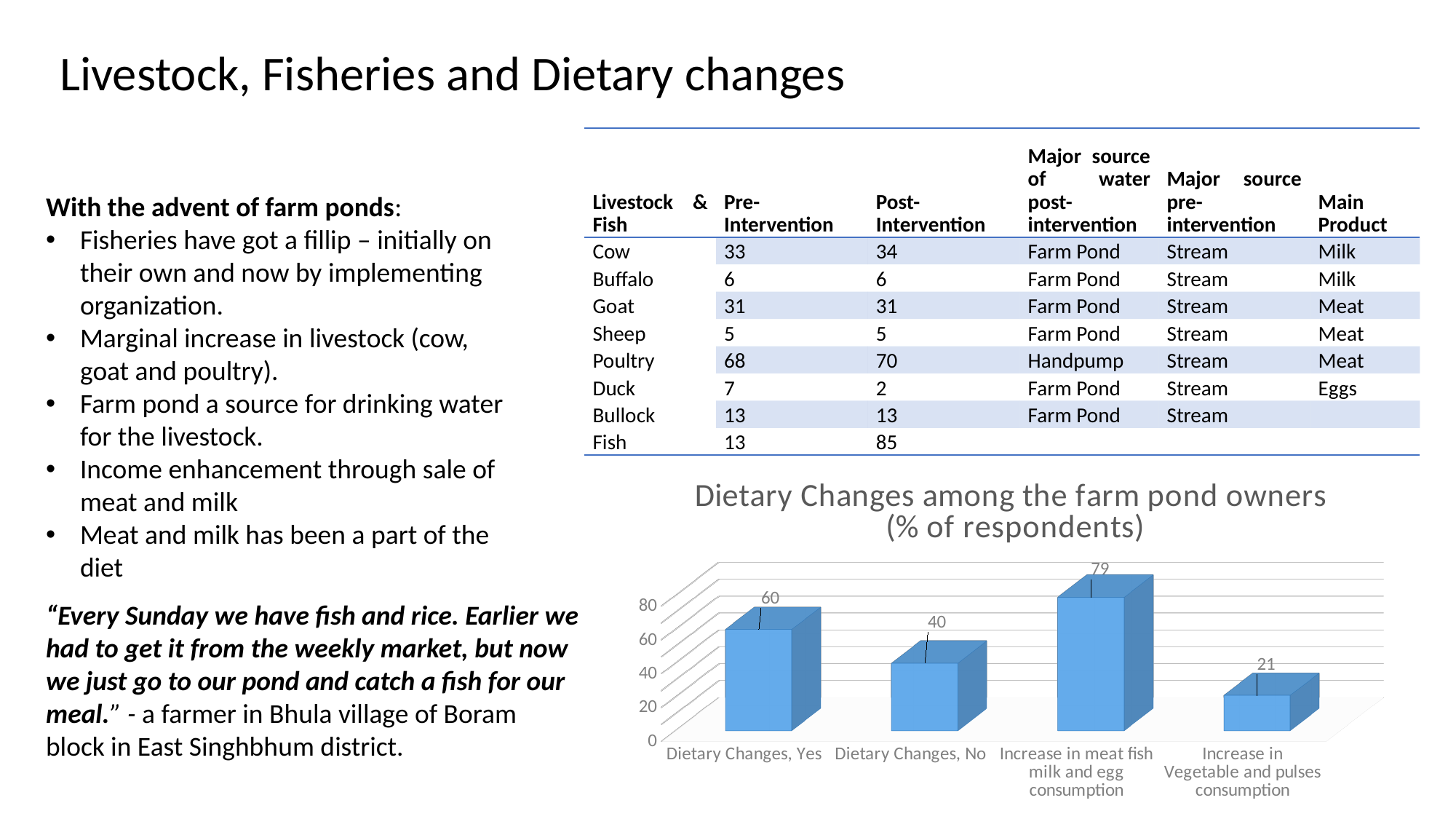
Which category has the highest value in the chart? Increase in meat fish milk and egg consumption What is the difference between the values for "Dietary Changes, Yes" and "Dietary Changes, No"? 20 What is the value for "Increase in Vegetable and pulses consumption" in the chart? 21 What is the title of the chart? Dietary Changes among the farm pond owners (% of respondents) What is the difference between the values for "Increase in meat fish milk and egg consumption" and "Increase in Vegetable and pulses consumption"? 58 How many categories are shown in the chart? 4 What is the value for "Increase in meat fish milk and egg consumption" in the chart? 79 What is the value for "Dietary Changes, No" in the chart? 40 Which category has the lowest value in the chart? Increase in Vegetable and pulses consumption Which is larger: the value for "Dietary Changes, Yes" or the value for "Increase in meat fish milk and egg consumption"? Increase in meat fish milk and egg consumption What kind of chart is shown on the slide? Bar chart What is the value for "Dietary Changes, Yes" in the chart? 60